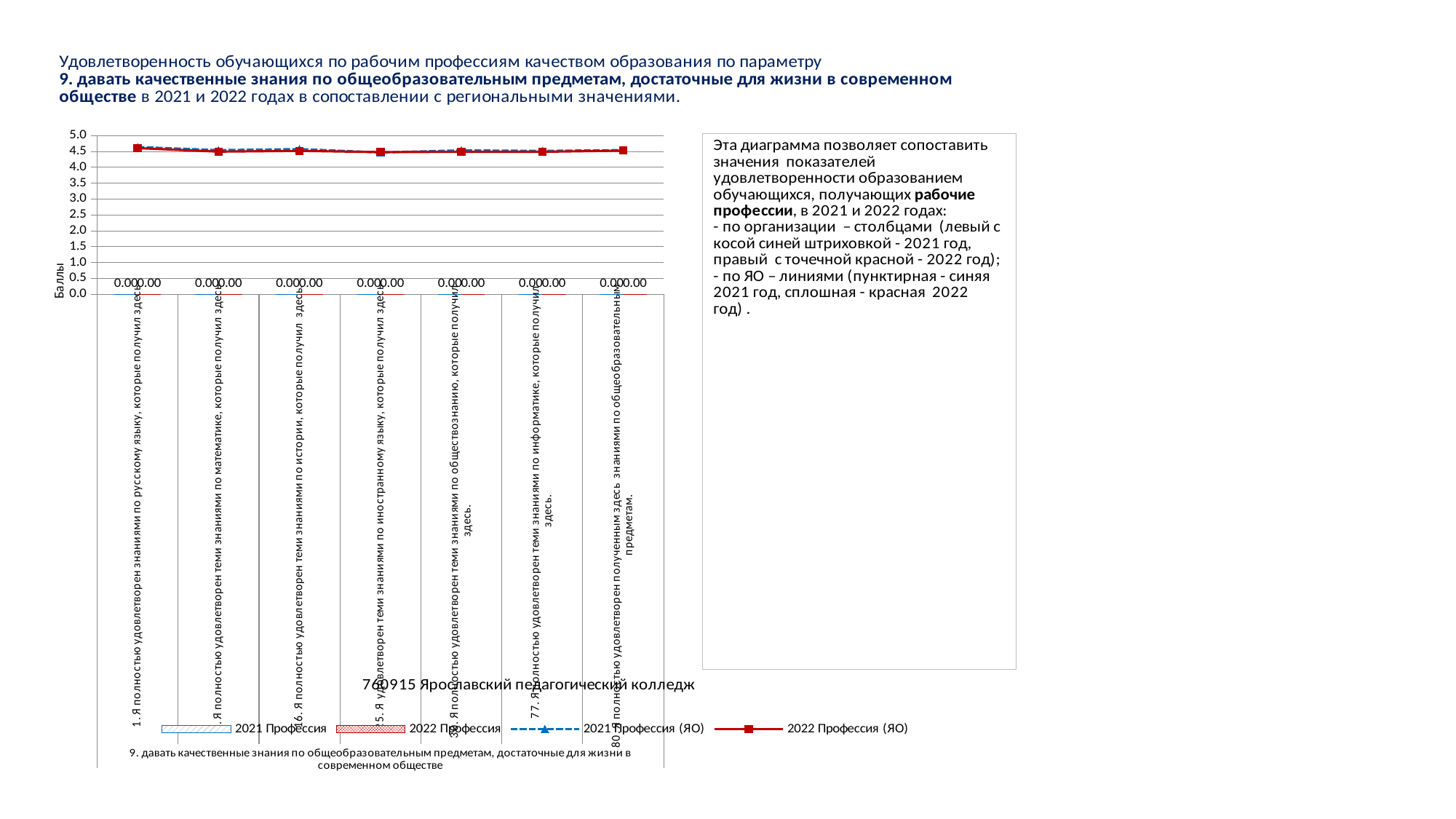
What is the value of the 2021 Профессия bar for the category about информатике (computer science)? 0.00 What is the value of the 2022 Профессия bar for the category about математике (mathematics)? 0.00 How many categories are shown along the x axis of the chart? 7 Is the value of the 2022 Профессия (ЯО) line for the category about информатике greater or less than 4.0? greater Is the value of the 2022 Профессия (ЯО) line for the category about русскому языку greater or less than 4.0? greater How many series does the chart legend list? 4 What is the title of the vertical axis of the chart? Баллы What kind of chart is shown on the slide? Combined bar and line chart Is the value of the 2021 Профессия (ЯО) line for the category about обществознанию greater or less than 3.0? greater What is the value of the 2021 Профессия bar for the category about русскому языку (Russian language)? 0.00